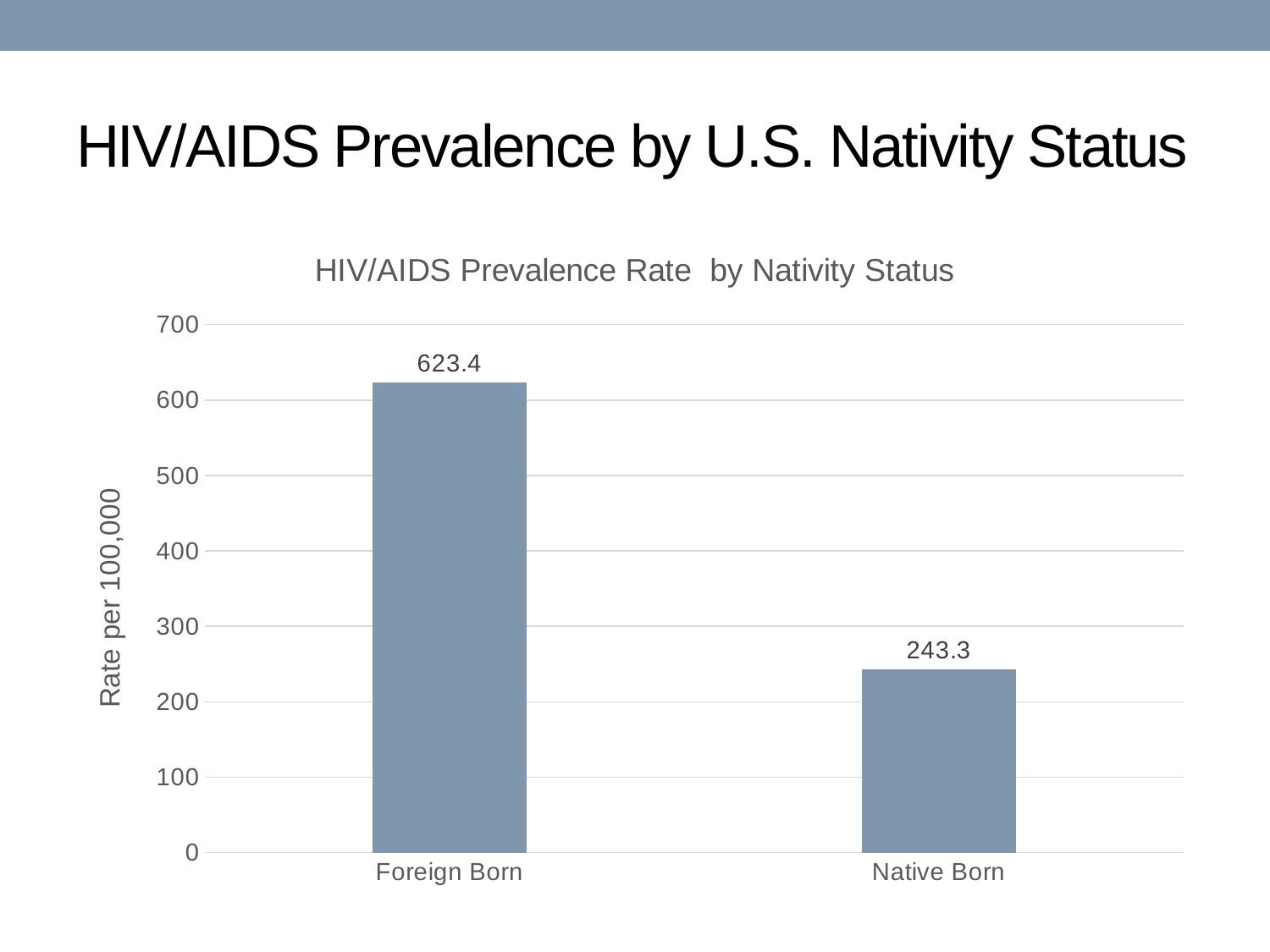
What kind of chart is shown on the slide? bar chart Which is larger, the rate for Foreign Born or the rate for Native Born? Foreign Born What is the HIV/AIDS prevalence rate for Native Born? 243.3 What is the difference between the Foreign Born and Native Born prevalence rates? 380.1 What is the label of the vertical axis? Rate per 100,000 Which nativity status has the lowest HIV/AIDS prevalence rate? Native Born How many categories are shown on the chart? 2 Is the value for Native Born greater or less than 300? less Which nativity status has the highest HIV/AIDS prevalence rate? Foreign Born What is the title of the chart? HIV/AIDS Prevalence Rate by Nativity Status What is the HIV/AIDS prevalence rate for Foreign Born? 623.4 Is the value for Foreign Born greater or less than 600? greater